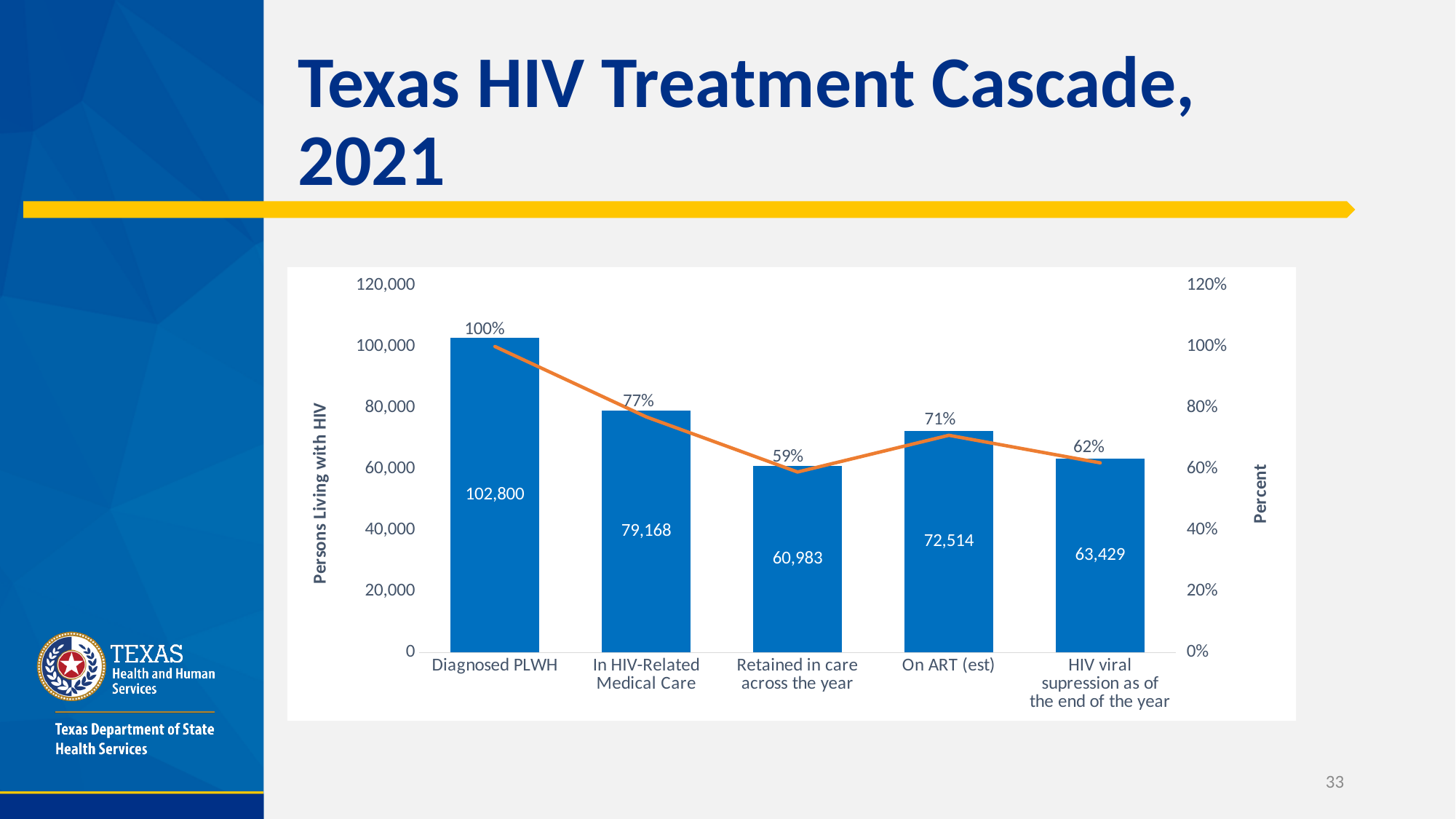
What is the difference between the values for Diagnosed PLWH and On ART (est)? 30,286 What is the label of the left vertical axis? Persons Living with HIV Is the value for In HIV-Related Medical Care greater or less than 80,000? less What percentage is shown for HIV viral supression as of the end of the year? 62% How many persons are shown for Diagnosed PLWH? 102,800 What percentage is shown for Retained in care across the year? 59% How many categories are shown on the x axis? 5 Which is larger, the value for On ART (est) or the value for HIV viral supression as of the end of the year? On ART (est) Which category has the highest number of persons living with HIV? Diagnosed PLWH Which category has the lowest number of persons living with HIV? Retained in care across the year What kind of chart is this? Combined bar and line chart What is the value for In HIV-Related Medical Care? 79,168